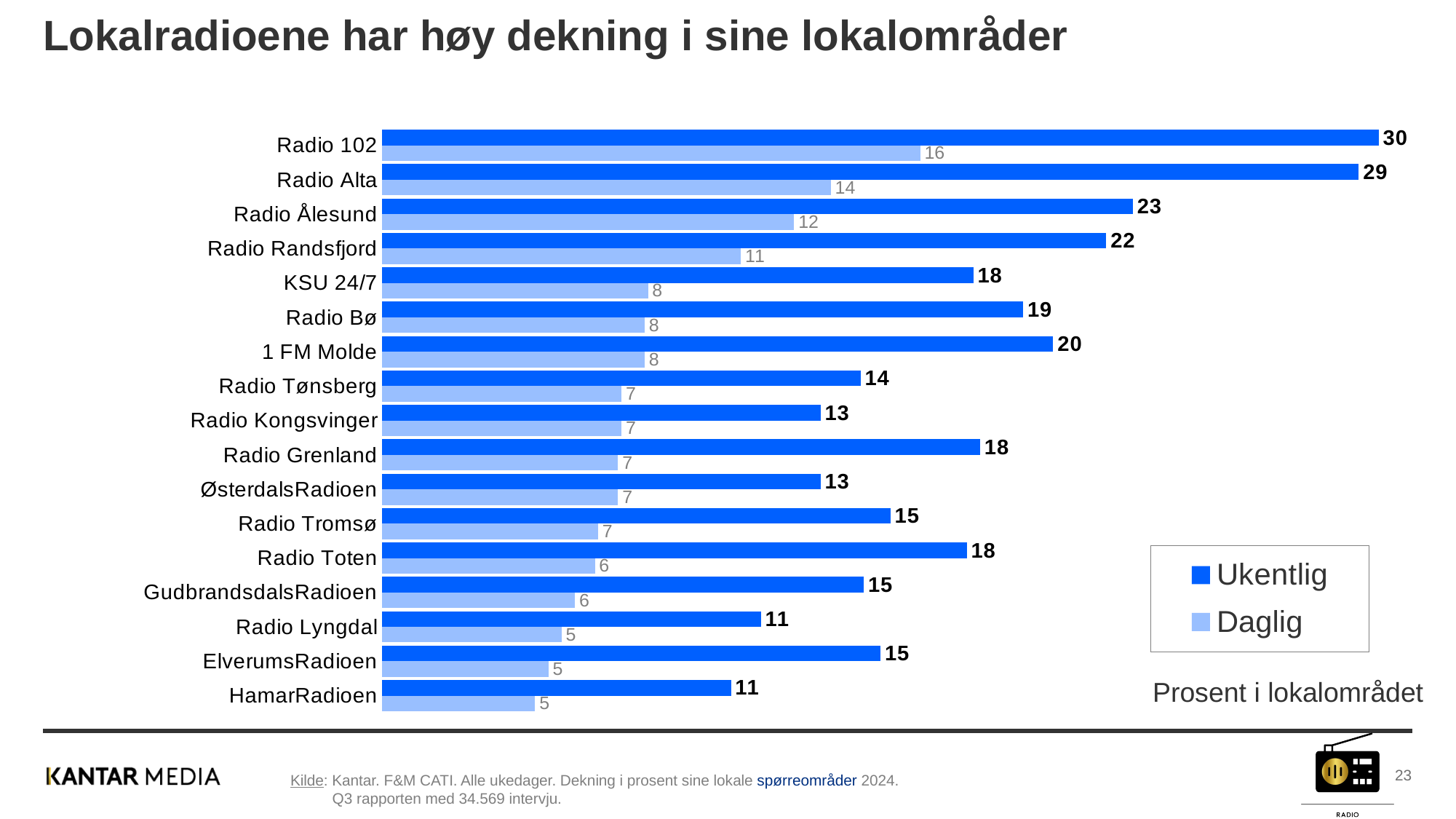
What is the difference between the Ukentlig values for Radio 102 and HamarRadioen? 19 Which station has the lowest Daglig value among Radio Lyngdal, Radio Toten and Radio Tromsø? Radio Lyngdal What is the difference between the Ukentlig and Daglig values for Radio Ålesund? 11 What is the Ukentlig value for Radio Grenland? 18 Which is larger, the Ukentlig value for Radio Bø or for 1 FM Molde? 1 FM Molde How many series does the legend list? 2 What are the two series named in the legend? Ukentlig and Daglig Which station has the highest Ukentlig value? Radio 102 What is the Daglig value for Radio Alta? 14 What kind of chart is shown on the slide? Bar chart How many stations are shown in the chart? 17 What is the Ukentlig value for Radio 102? 30